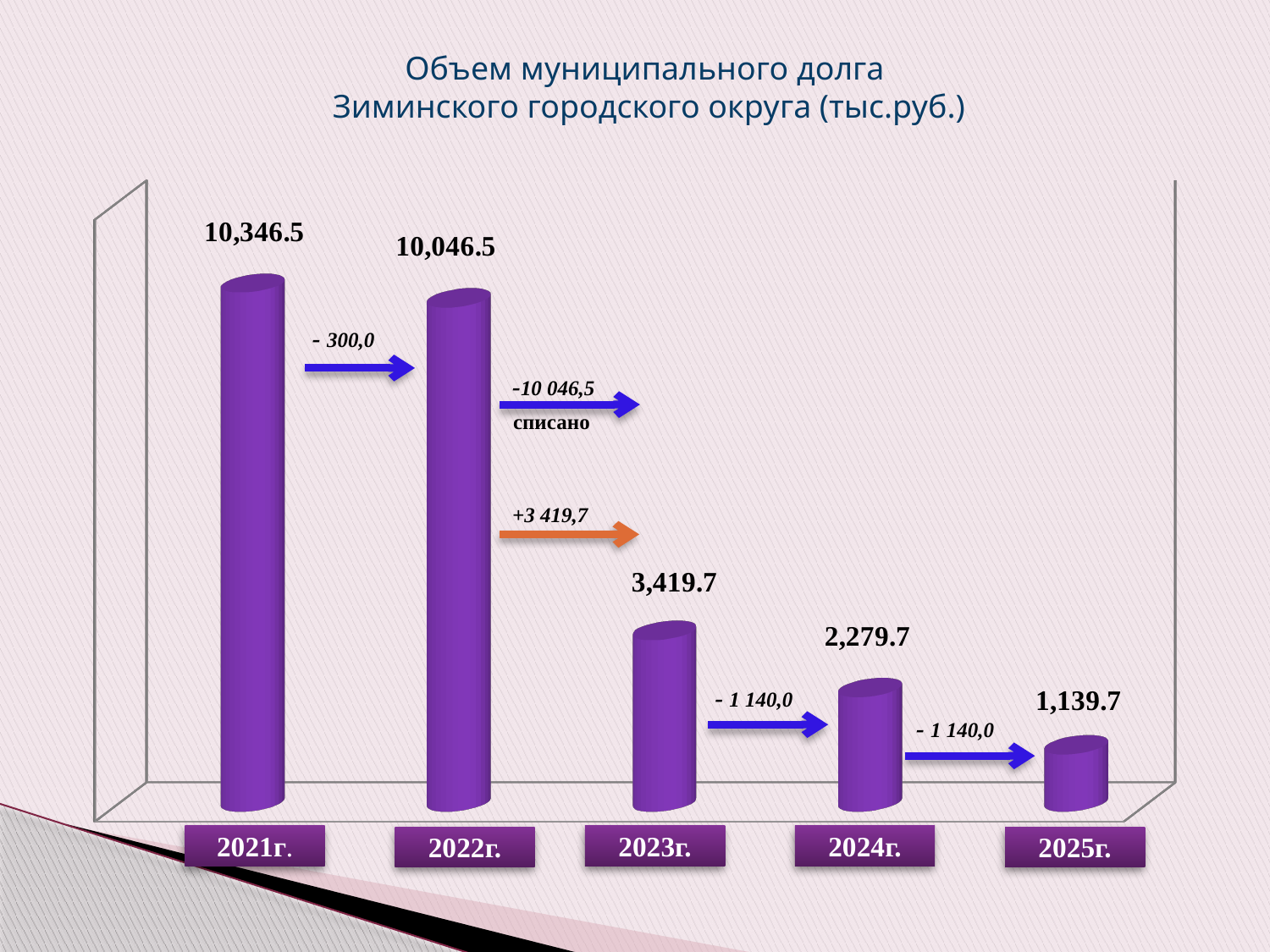
What is the value for 2021г.? 10,346.5 What is the value for 2025г.? 1,139.7 What is the difference between the values for 2024г. and 2025г.? 1,140.0 Which year has the lowest value? 2025г. Do the values rise or fall from 2021г. to 2025г.? fall What is the value for 2023г.? 3,419.7 Which is larger, the value for 2023г. or the value for 2024г.? 2023г. How many years are shown on the chart? 5 What kind of chart is this? bar chart Which year has the highest value? 2021г. What is the difference between the values for 2021г. and 2022г.? 300.0 What is the title of the chart? Объем муниципального долга Зиминского городского округа (тыс.руб.)